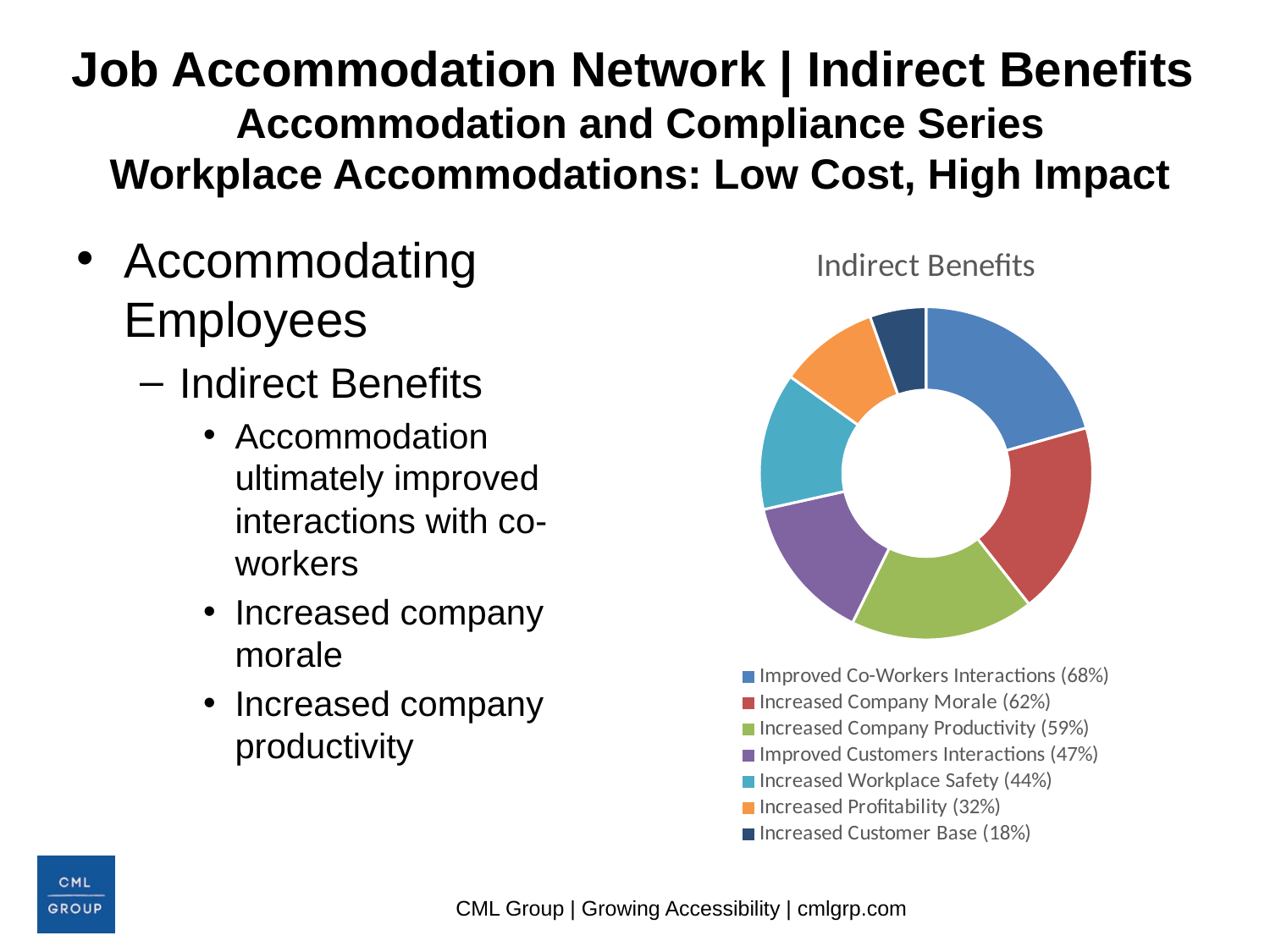
What colour is the slice for Increased Profitability? Orange What is the difference between Increased Company Productivity and Increased Profitability? 27% What is the title of the chart? Indirect Benefits How many categories does the chart's legend list? 7 What kind of chart is shown on the slide? Doughnut chart Which category has the lowest value? Increased Customer Base What is the value for Improved Co-Workers Interactions? 68% What is the value for Increased Workplace Safety? 44% What is the value for Increased Customer Base? 18% Which is larger, Improved Customers Interactions or Increased Workplace Safety? Improved Customers Interactions Which category has the highest value? Improved Co-Workers Interactions What is the value for Increased Company Morale? 62%